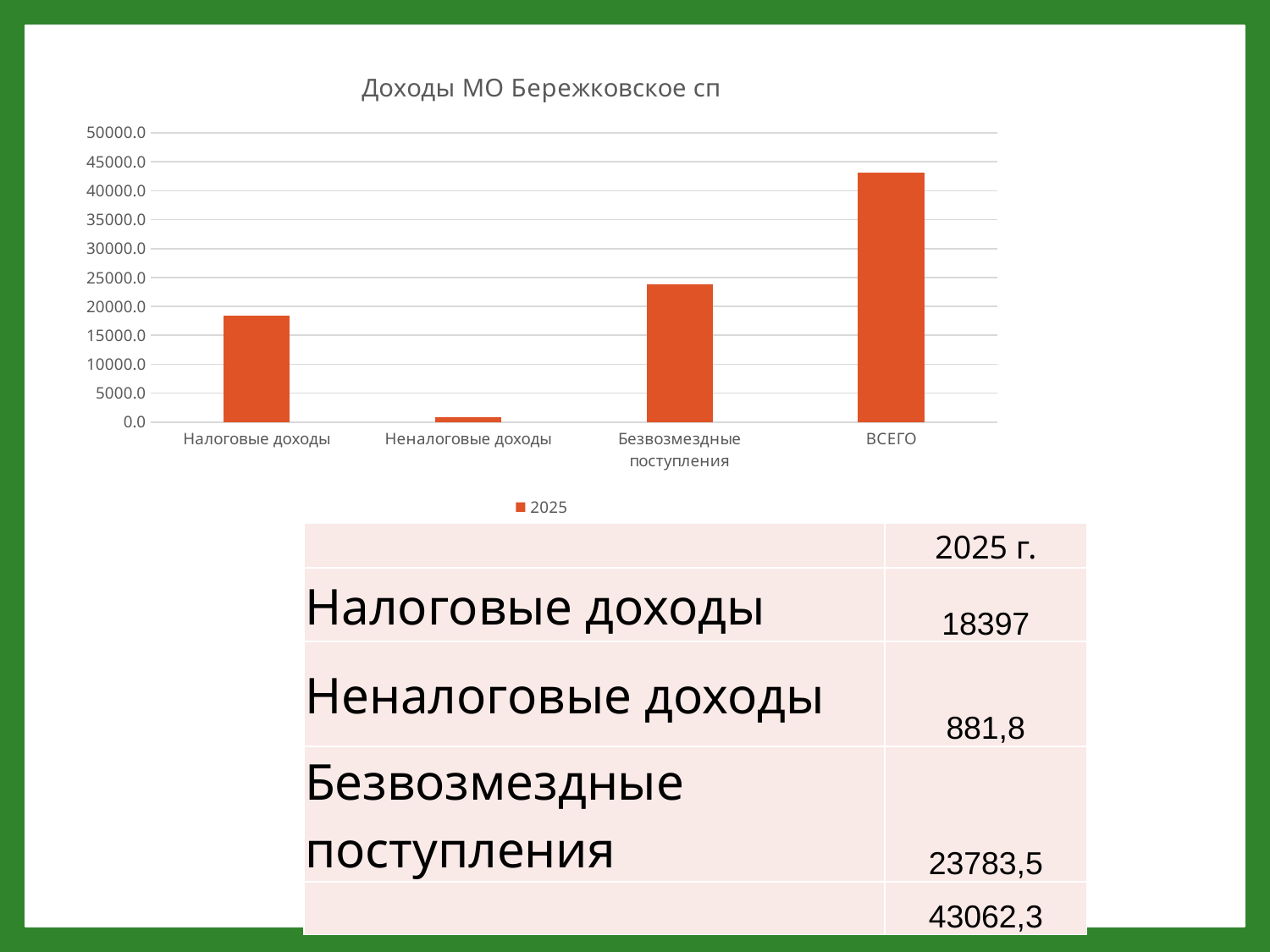
According to the table on the slide, what is the value for Налоговые доходы in 2025? 18397 Which is larger, the bar for Налоговые доходы or the bar for Безвозмездные поступления? Безвозмездные поступления What kind of chart is shown on the slide? bar chart Is the value for ВСЕГО greater or less than 40000.0? greater Which category has the highest bar in the chart? ВСЕГО According to the table on the slide, what is the value for Неналоговые доходы in 2025? 881,8 Which category has the lowest bar in the chart? Неналоговые доходы Is the value for Налоговые доходы greater or less than 20000.0? less How many categories are shown on the x axis of the chart? 4 Is the value for Безвозмездные поступления greater or less than 20000.0? greater What is the title of the chart? Доходы МО Бережковское сп How many series does the chart legend list? 1